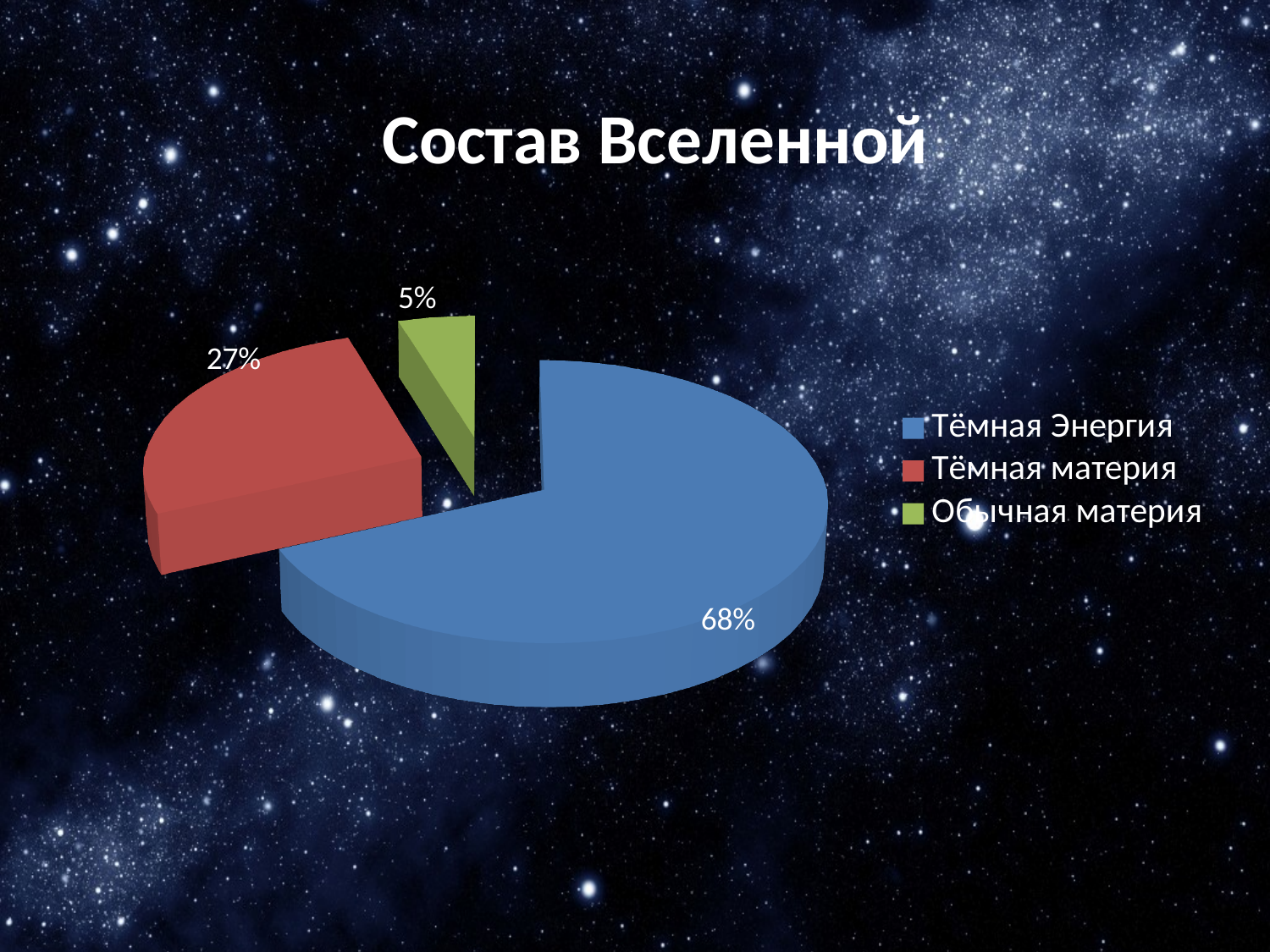
What share of the pie does Тёмная материя have? 27% What is the difference in percentage points between Тёмная Энергия and Тёмная материя? 41 Which is larger, the slice for Тёмная материя or the slice for Обычная материя? Тёмная материя How many categories does the pie chart show? 3 Which category has the largest slice of the pie? Тёмная Энергия What share of the pie does Обычная материя have? 5% What share of the pie does Тёмная Энергия have? 68% What is the difference in percentage points between Тёмная материя and Обычная материя? 22 What kind of chart is shown on the slide? Pie chart Which category has the smallest slice of the pie? Обычная материя What colour is the slice for Обычная материя? Green What is the title of the chart? Состав Вселенной